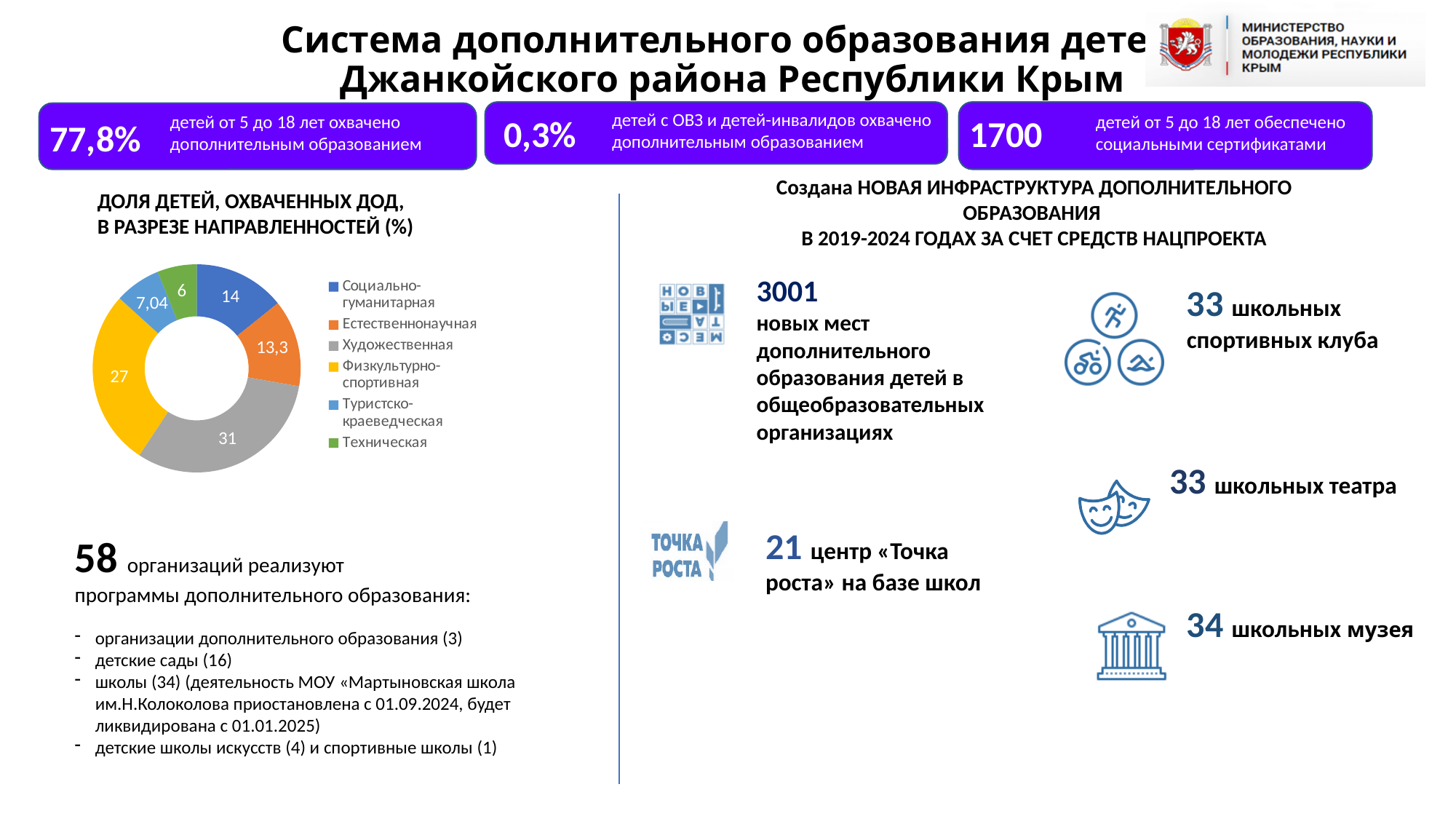
What is the value for Туристско-краеведческая in the doughnut chart? 7,04 In the doughnut chart, which is larger: Социально-гуманитарная or Техническая? Социально-гуманитарная What is the difference between the values for Художественная and Физкультурно-спортивная in the doughnut chart? 4 How many categories does the doughnut chart show? 6 What is the value for Физкультурно-спортивная in the doughnut chart? 27 What is the value for Естественнонаучная in the doughnut chart? 13,3 What type of chart is shown under the title "ДОЛЯ ДЕТЕЙ, ОХВАЧЕННЫХ ДОД, В РАЗРЕЗЕ НАПРАВЛЕННОСТЕЙ (%)"? Doughnut (pie) chart Which category has the largest value in the doughnut chart? Художественная Which category has the smallest value in the doughnut chart? Техническая What colour represents Физкультурно-спортивная in the doughnut chart? Yellow What is the value for Художественная in the doughnut chart? 31 What is the difference between the values for Социально-гуманитарная and Естественнонаучная in the doughnut chart? 0,7